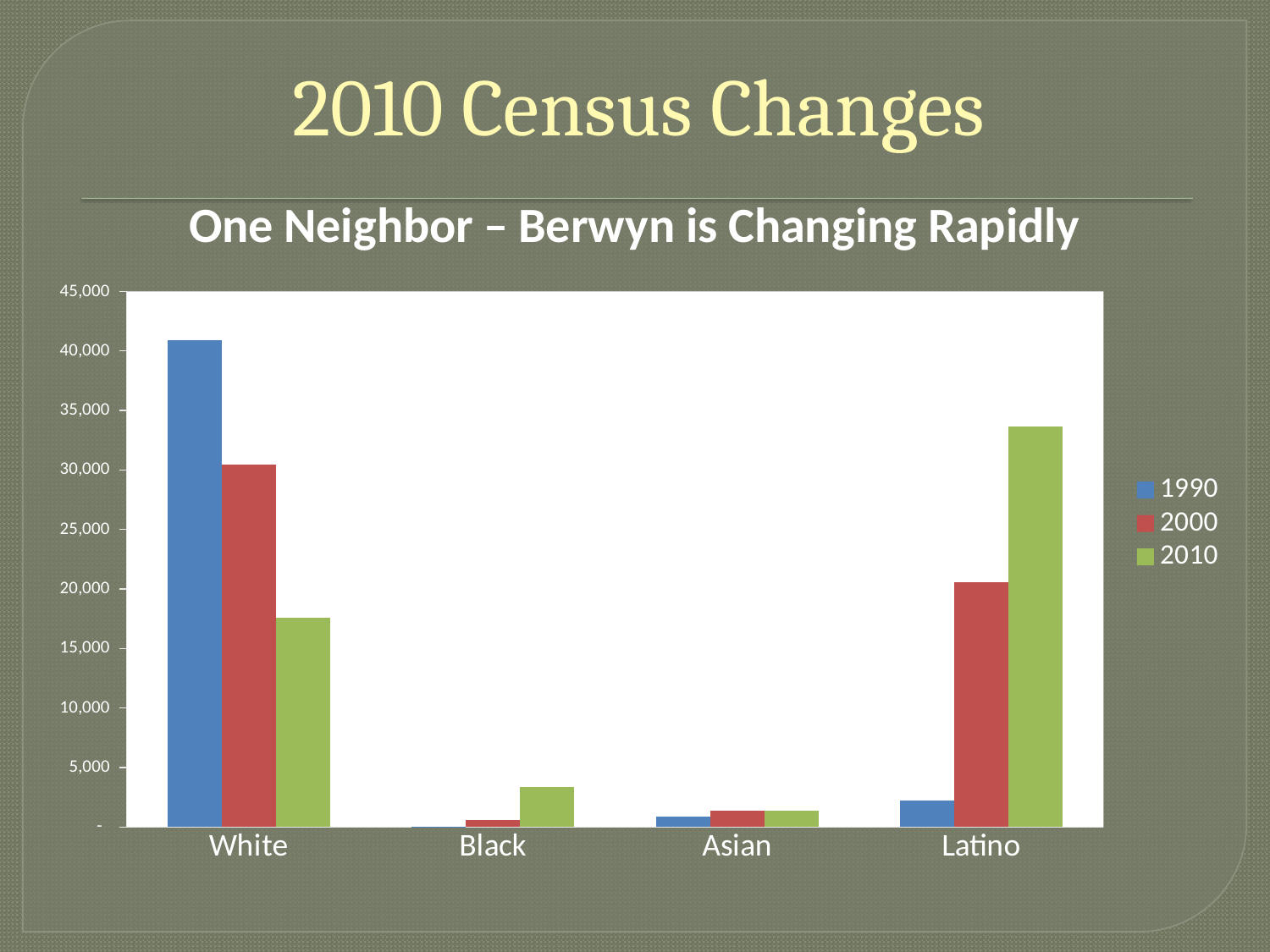
Is the 2010 value for White greater or less than 20,000? less What kind of chart is shown on the slide? bar chart How many categories are shown on the x axis of the chart? 4 Which is larger, the 2000 value for White or the 2000 value for Latino? White Which category has the lowest value for 2010? Asian Which category has the highest value for 2010? Latino Which category has the highest value for 1990? White How many series does the legend list? 3 Is the 1990 value for White greater or less than 40,000? greater Do the values for White rise or fall from 1990 to 2010? fall Is the 2010 value for Latino greater or less than 30,000? greater What is the title shown above the chart? One Neighbor – Berwyn is Changing Rapidly